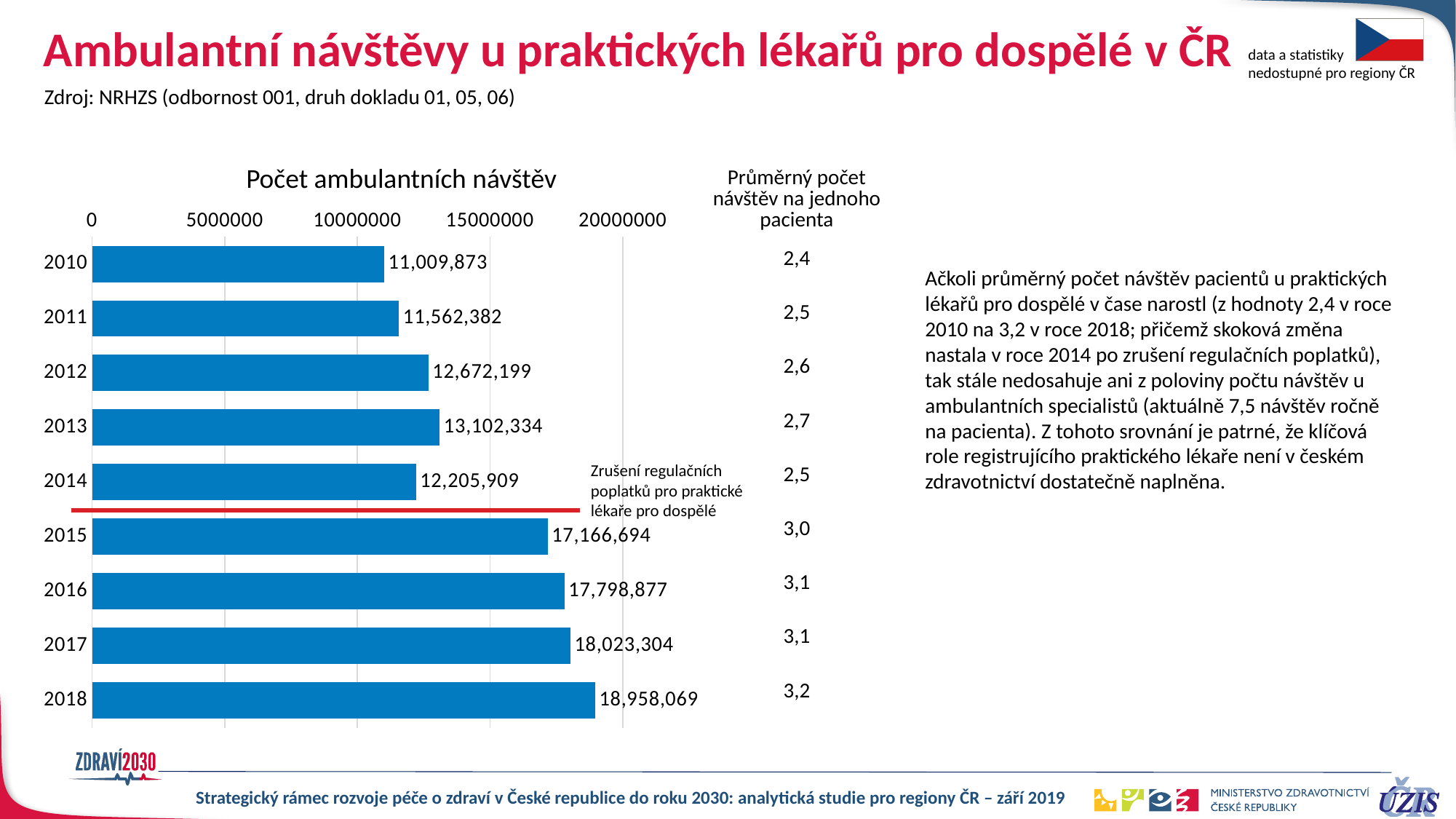
How many years are plotted in the chart? 9 Which year has the lowest number of outpatient visits in the chart? 2010 Which year has the highest number of outpatient visits in the chart? 2018 Is the value for 2016 greater or less than 15000000? greater What is the number of outpatient visits shown for 2010 in the chart? 11,009,873 What value does the chart show for 2015? 17,166,694 Which year has the larger value, 2013 or 2014? 2013 What is the value of the bar for 2018? 18,958,069 What type of chart is used to show the number of outpatient visits? bar chart What is the difference between the values for 2018 and 2010? 7,948,196 By how much does the value for 2015 exceed the value for 2014? 4,960,785 What is the title of the chart? Počet ambulantních návštěv